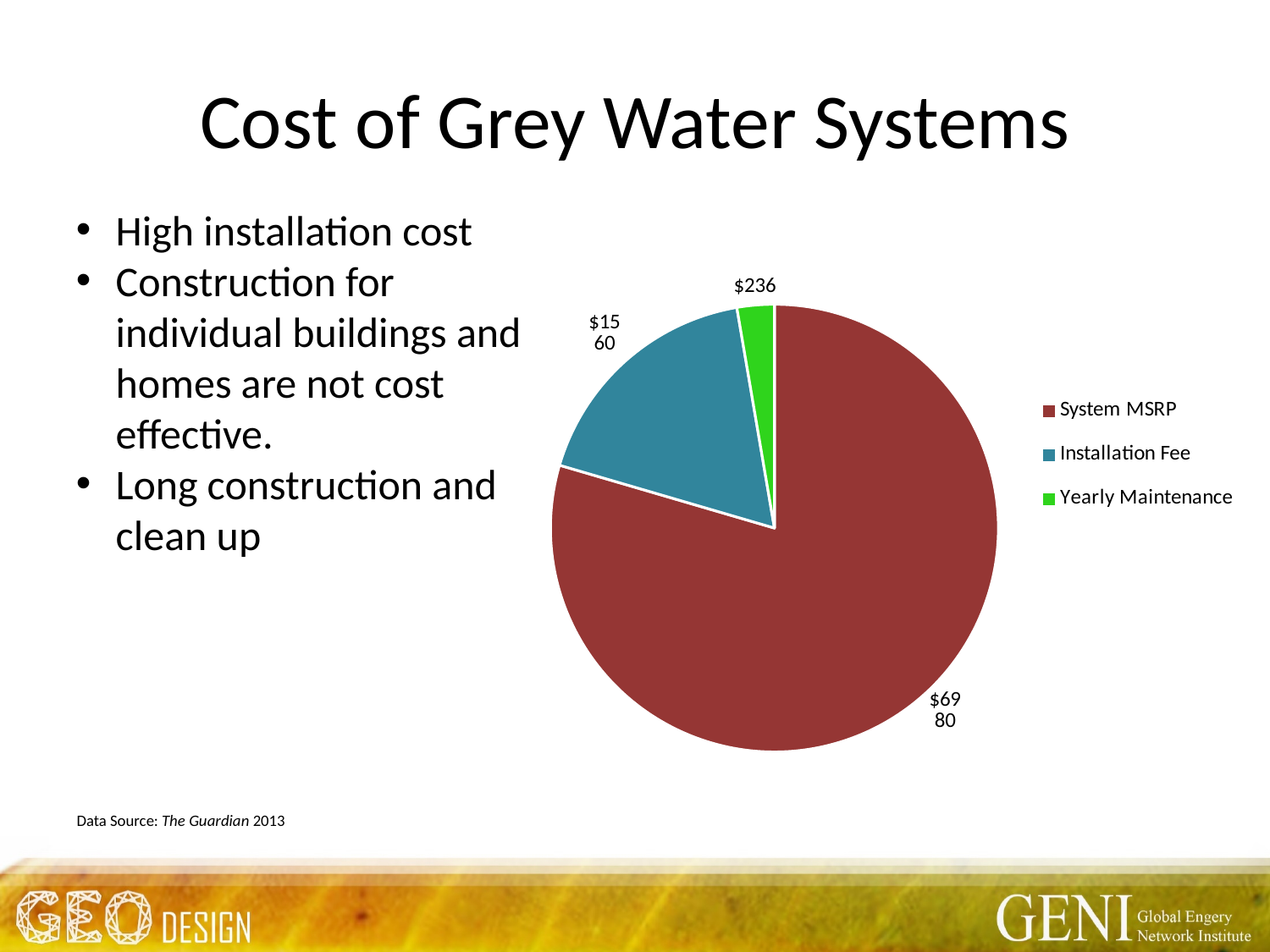
Which category has the smallest slice in the pie chart? Yearly Maintenance What is the total of all three values shown in the pie chart? $8776 What kind of chart is shown on the slide? pie chart What is the value shown for Yearly Maintenance in the pie chart? $236 Which is larger in the pie chart, Installation Fee or Yearly Maintenance? Installation Fee How many entries does the legend of the pie chart list? 3 What colour is the Yearly Maintenance slice in the pie chart? green How many slices does the pie chart have? 3 What is the value shown for Installation Fee in the pie chart? $1560 Which category has the largest slice in the pie chart? System MSRP What is the value shown for System MSRP in the pie chart? $6980 What is the difference between the System MSRP value and the Installation Fee value in the pie chart? $5420